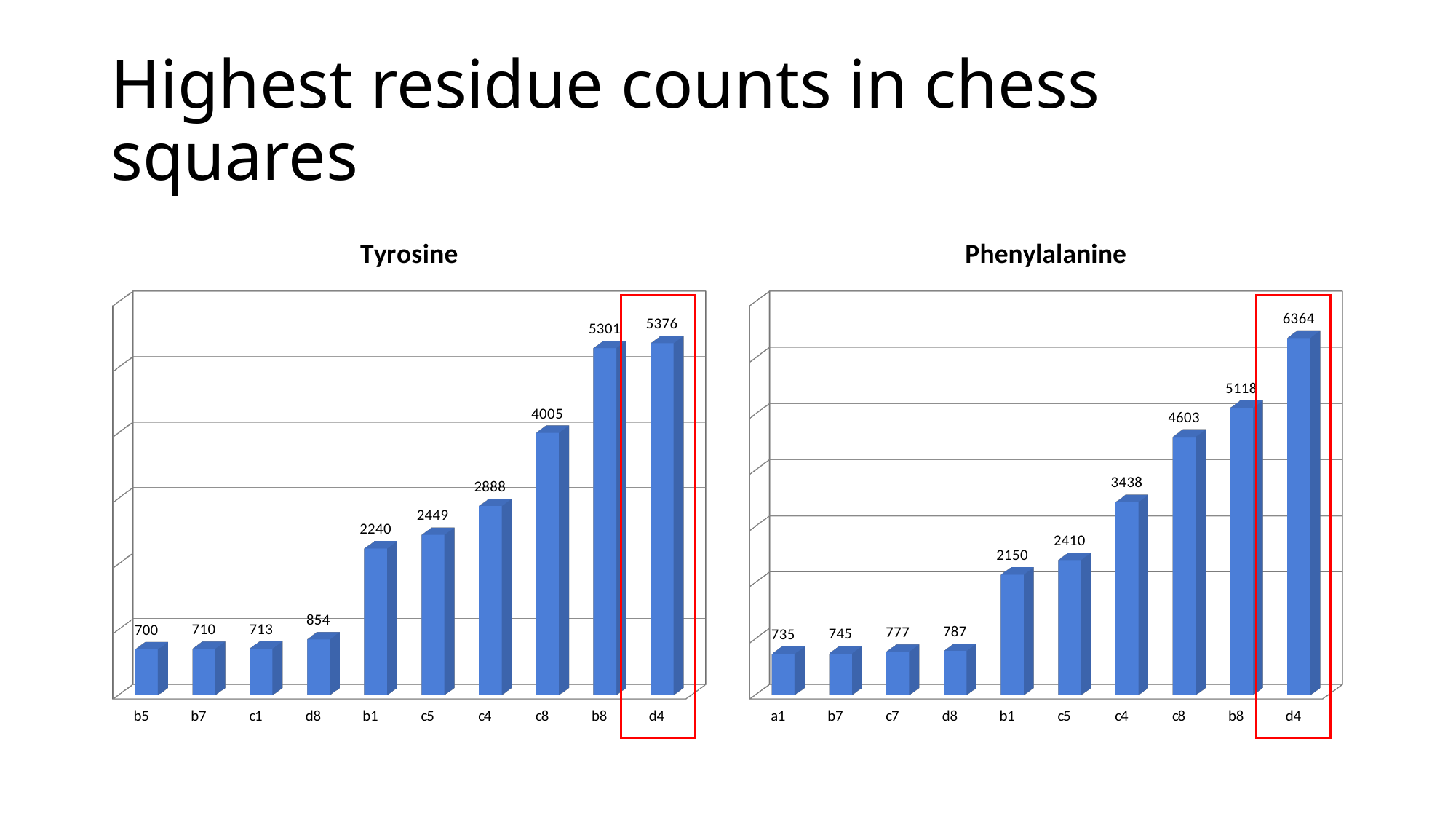
In the Tyrosine chart, do the values rise or fall from left to right? rise In the Phenylalanine chart, what is the value for c4? 3438 In the Phenylalanine chart, what is the difference between the values for d4 and b8? 1246 How many squares are shown in the Tyrosine chart? 10 In the Tyrosine chart, what is the value for c8? 4005 In the Phenylalanine chart, which square has the lowest count? a1 What is the title of the chart on the right? Phenylalanine In the Phenylalanine chart, which square is outlined with a red box? d4 In the Tyrosine chart, which square has the highest count? d4 In the Phenylalanine chart, which is larger, the value for c8 or the value for c5? c8 What kind of chart is the Phenylalanine chart? bar chart In the Tyrosine chart, what is the difference between the values for d4 and b8? 75